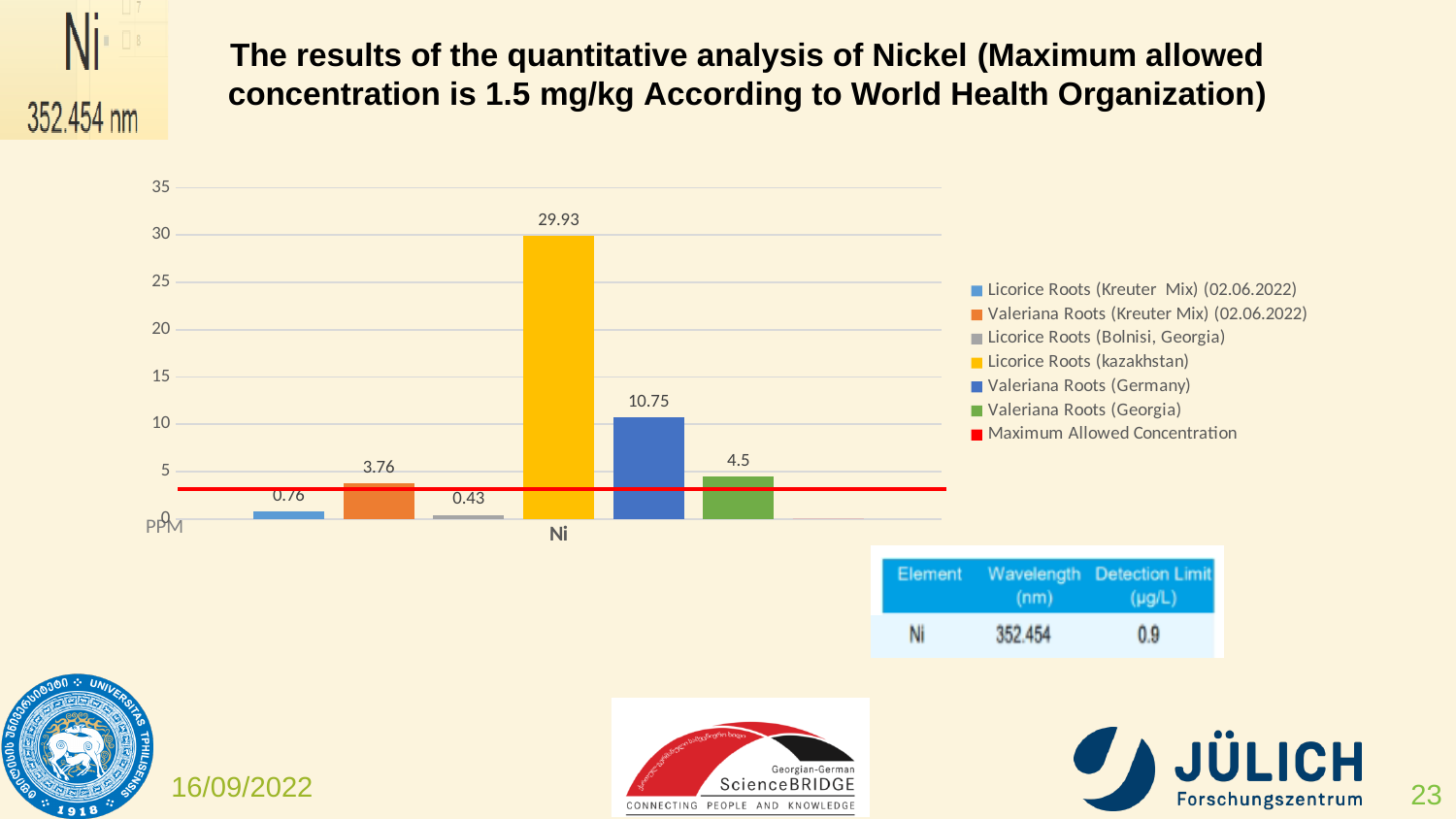
What is the Nickel value for Valeriana Roots (Germany)? 10.75 What is the label on the x axis under the bars? Ni Is the value for Valeriana Roots (Germany) greater or less than 10? greater What is the difference between the Nickel values for Licorice Roots (kazakhstan) and Valeriana Roots (Germany)? 19.18 Which series has the lowest Nickel value? Licorice Roots (Bolnisi, Georgia) What is the Nickel value for Licorice Roots (kazakhstan)? 29.93 What is the Nickel value for Valeriana Roots (Kreuter Mix) (02.06.2022)? 3.76 Which is larger, the Nickel value for Valeriana Roots (Georgia) or for Valeriana Roots (Kreuter Mix) (02.06.2022)? Valeriana Roots (Georgia) What is the Nickel value for Licorice Roots (Bolnisi, Georgia)? 0.43 How many entries does the legend list? 7 What kind of chart is shown on the slide? bar chart Which series has the highest Nickel value? Licorice Roots (kazakhstan)